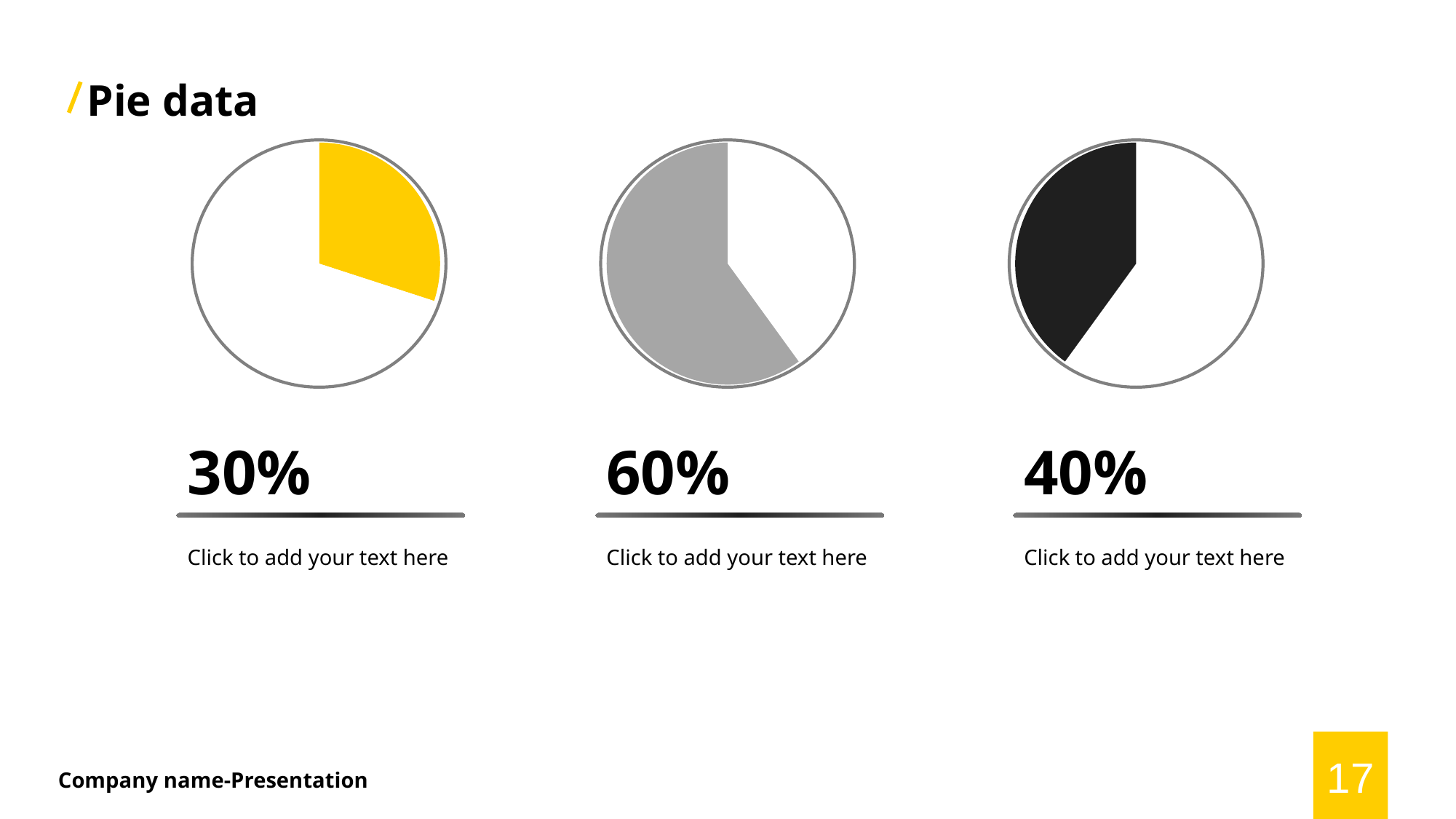
Which pie chart on the slide shows the largest percentage? the middle pie chart (60%) What is the title of the slide containing the pie charts? Pie data What percentage is printed below the left pie chart? 30% What is the difference between the percentage shown for the middle pie chart and the left pie chart? 30% Which is larger, the percentage for the right pie chart or the left pie chart? the right pie chart (40%) Which pie chart on the slide shows the smallest percentage? the left pie chart (30%) Is the percentage shown for the middle pie chart greater or less than 50%? greater What percentage is printed below the middle pie chart? 60% What percentage is printed below the right pie chart? 40% What kind of chart is shown on the left of the slide? pie chart How many pie charts are shown on the slide? 3 What colour is the filled slice in the left pie chart? yellow